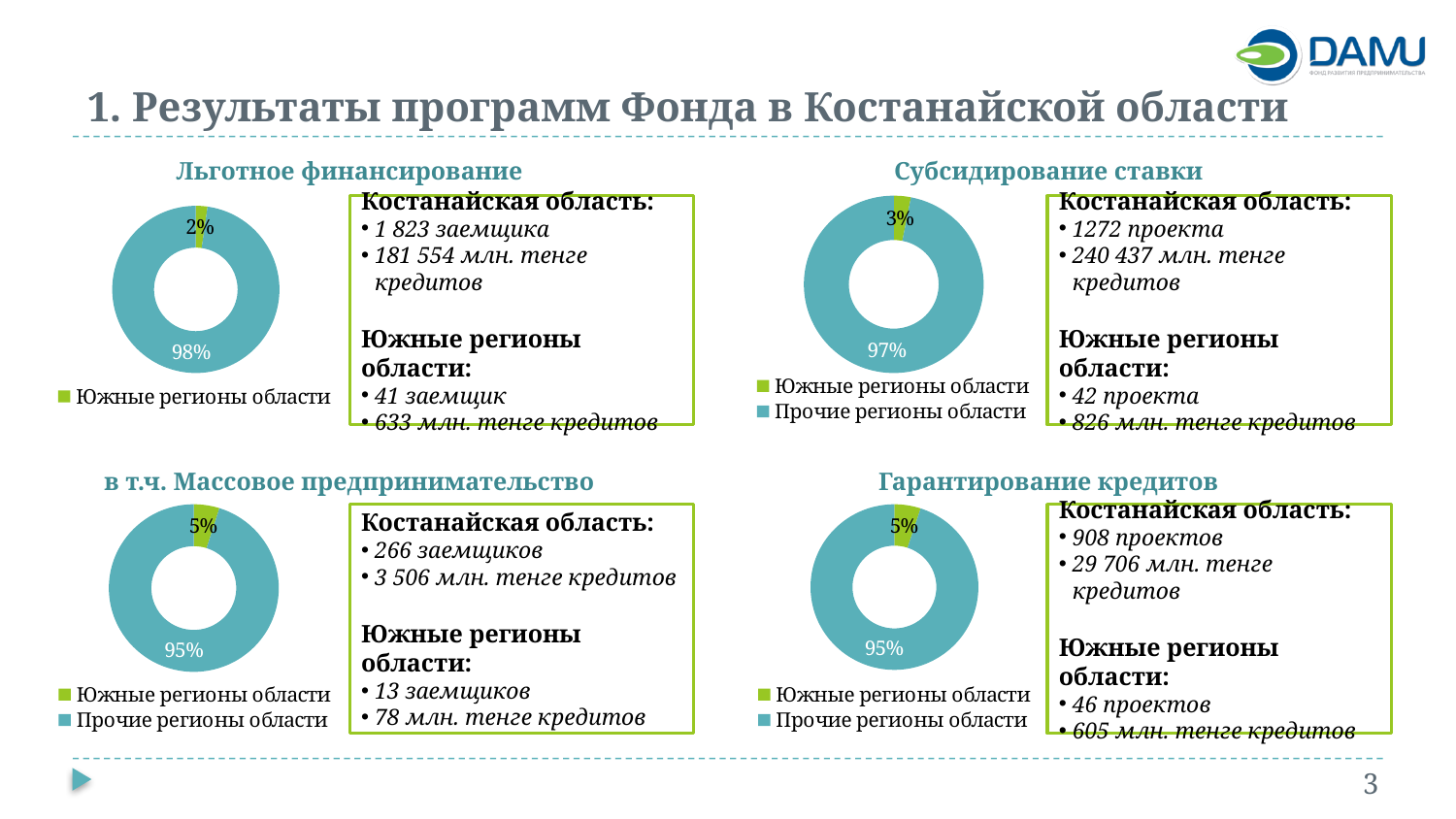
In the "Субсидирование ставки" chart, which category has the smallest slice? Южные регионы области In the "Льготное финансирование" chart, what share is labelled for the large teal slice? 98% In the "Льготное финансирование" chart, what share is labelled for the green slice (Южные регионы области)? 2% In the "Гарантирование кредитов" chart, what share is shown for Прочие регионы области? 95% How many pie (donut) charts are shown on the slide? 4 In the "Гарантирование кредитов" chart, which category has the largest slice? Прочие регионы области Which is larger: the share for Южные регионы области in the "Льготное финансирование" chart or in the "Гарантирование кредитов" chart? Гарантирование кредитов How many legend entries does the "Субсидирование ставки" chart list? 2 What kind of chart is used under the heading "Льготное финансирование"? Pie (donut) chart